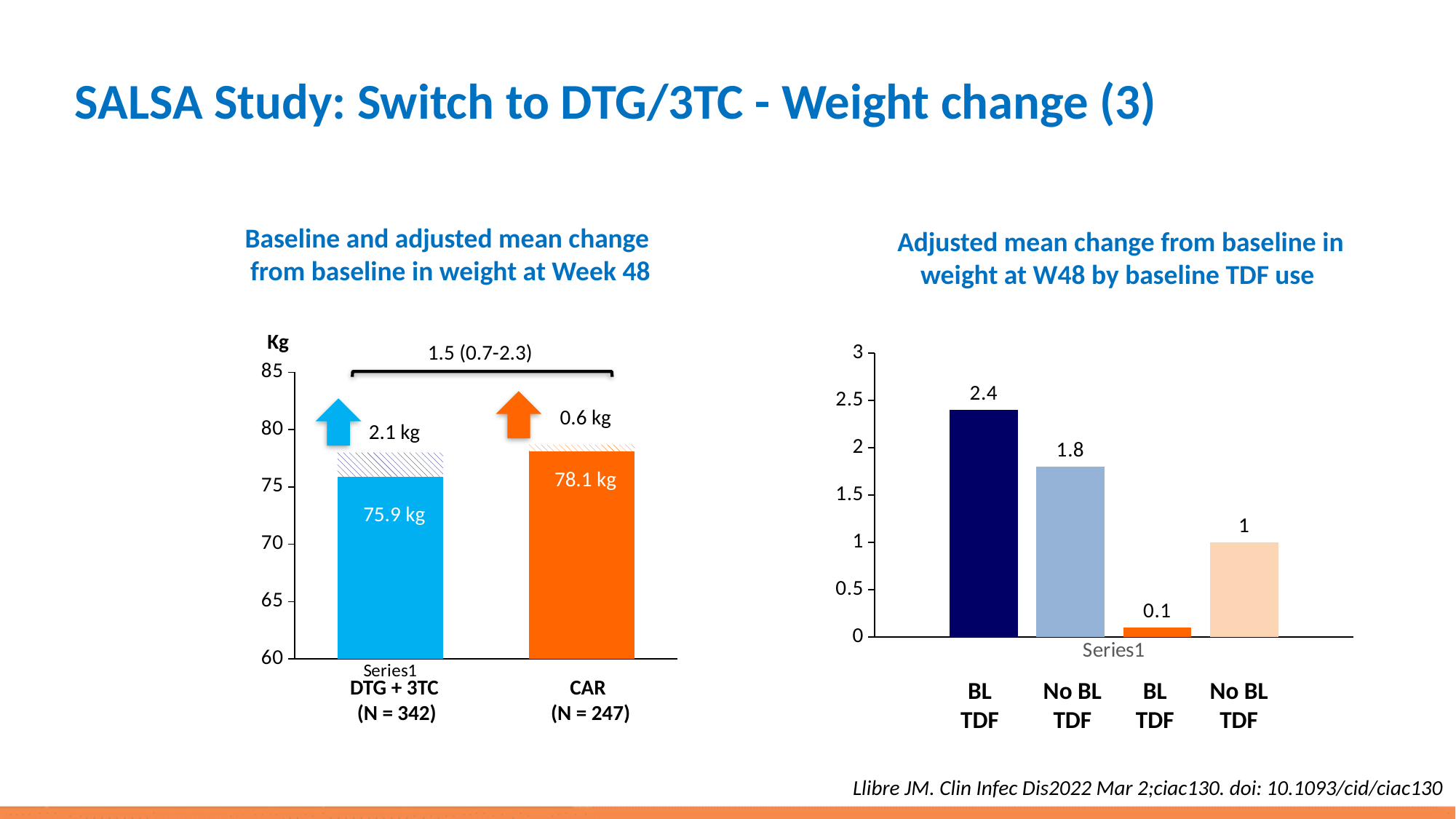
What type of chart is shown on the right side of the slide? Bar chart In the left chart, what is the adjusted mean change from baseline in weight for the DTG + 3TC group? 2.1 kg In the left chart, what is the baseline weight shown for the CAR group? 78.1 kg In the left chart, how many participants are in the CAR group? N = 247 In the left chart, what is the difference in weight change between the two groups shown above the bracket? 1.5 (0.7-2.3) In the right chart, what is the difference between the first bar (2.4) and the second bar (1.8)? 0.6 In the right chart, what is the value of the dark blue BL TDF bar (first bar)? 2.4 In the left chart, what is the baseline weight shown for the DTG + 3TC group? 75.9 kg In the right chart, which bar has the lowest value? BL TDF (third bar, 0.1) In the left chart, what is the adjusted mean change from baseline in weight for the CAR group? 0.6 kg In the left chart, which group has the larger weight gain, DTG + 3TC or CAR? DTG + 3TC In the right chart, what is the value of the light blue No BL TDF bar (second bar)? 1.8